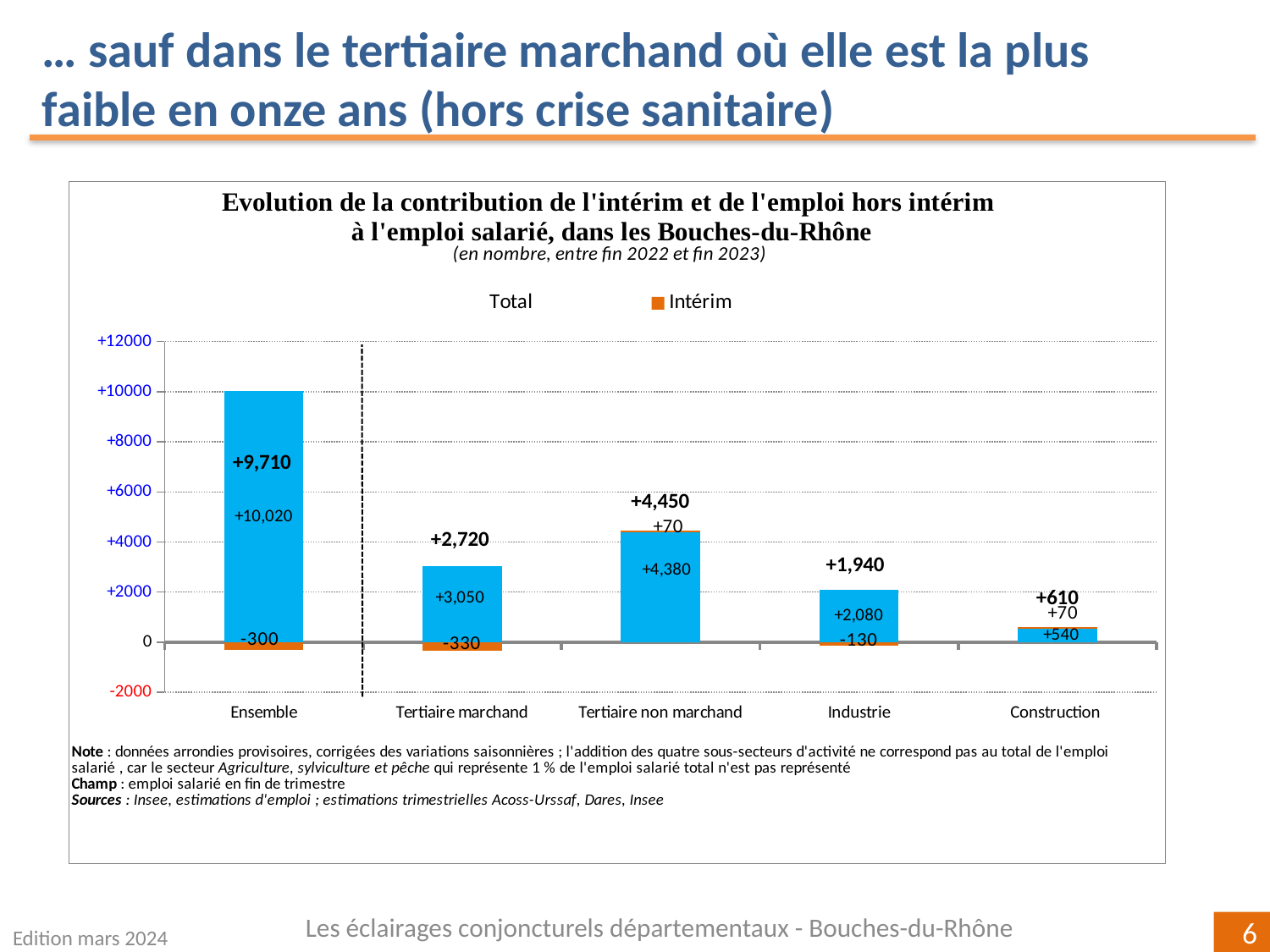
Which category has the lowest total? Construction Which is larger, the total for Tertiaire marchand or the total for Industrie? Tertiaire marchand What is the Intérim value for Construction? +70 What is the blue (hors intérim) value for Industrie? +2,080 How many categories are shown on the x axis? 5 Which category has the highest total? Ensemble What is the difference between the blue values for Tertiaire marchand and Industrie? 970 What kind of chart is this? Stacked bar chart What is the total shown above the bar for Tertiaire non marchand? +4,450 What is the Intérim value for Tertiaire marchand? -330 How many series does the legend list? 2 Which series is shown in orange? Intérim